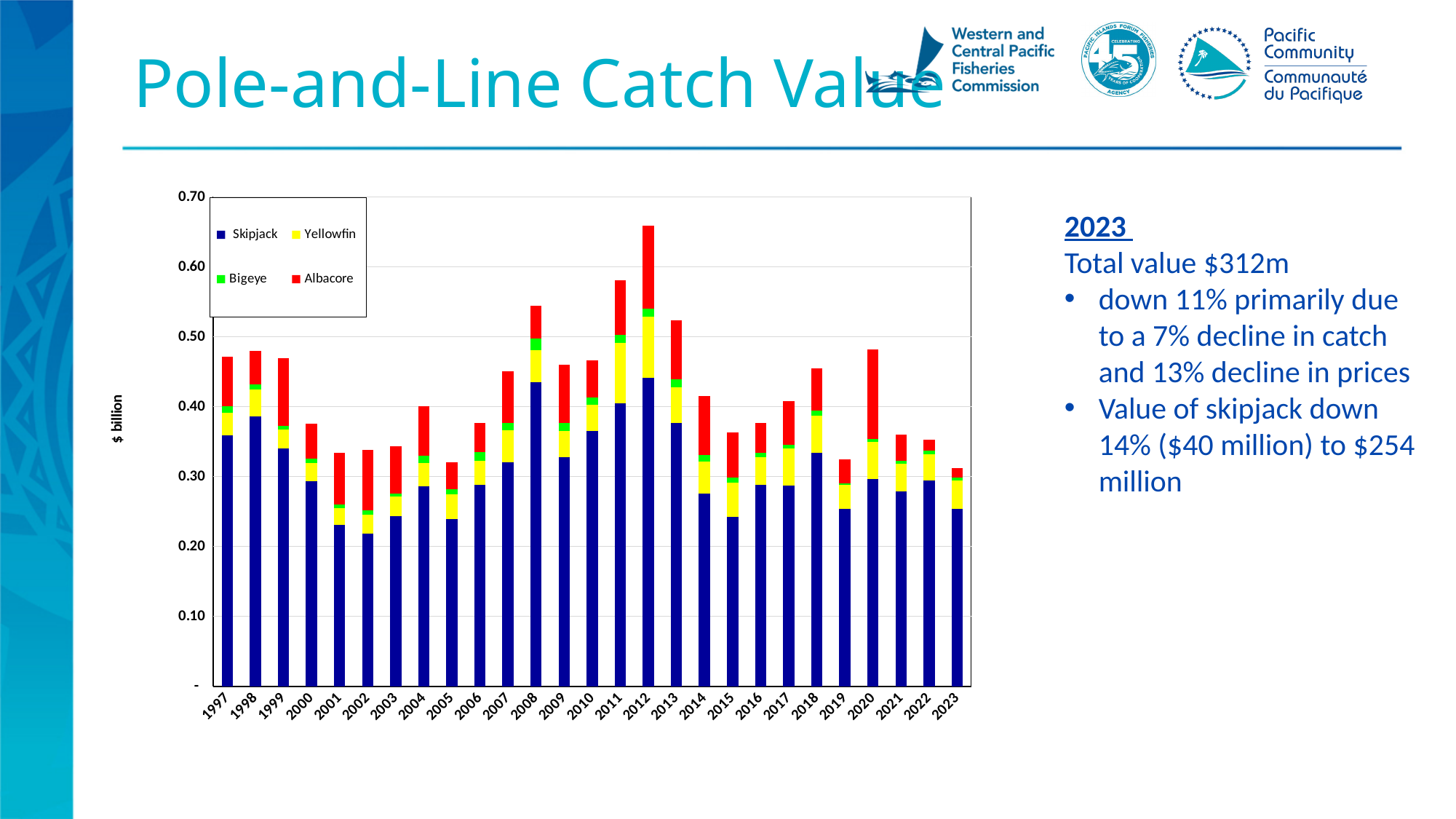
Is the total catch value for 2008 greater or less than 0.50 $ billion? greater Do the total catch values rise or fall from 2012 to 2015? fall Which year has the larger total catch value, 2008 or 2009? 2008 Is the total catch value for 2023 greater or less than 0.40 $ billion? less How many years are plotted along the x axis of the chart? 27 Is the Skipjack value for 2012 greater or less than 0.40 $ billion? greater Which year has the highest total pole-and-line catch value? 2012 What kind of chart is shown on the slide? Stacked bar chart What is the label on the y axis of the chart? $ billion Which year has the larger total catch value, 2020 or 2021? 2020 How many series does the chart legend list? 4